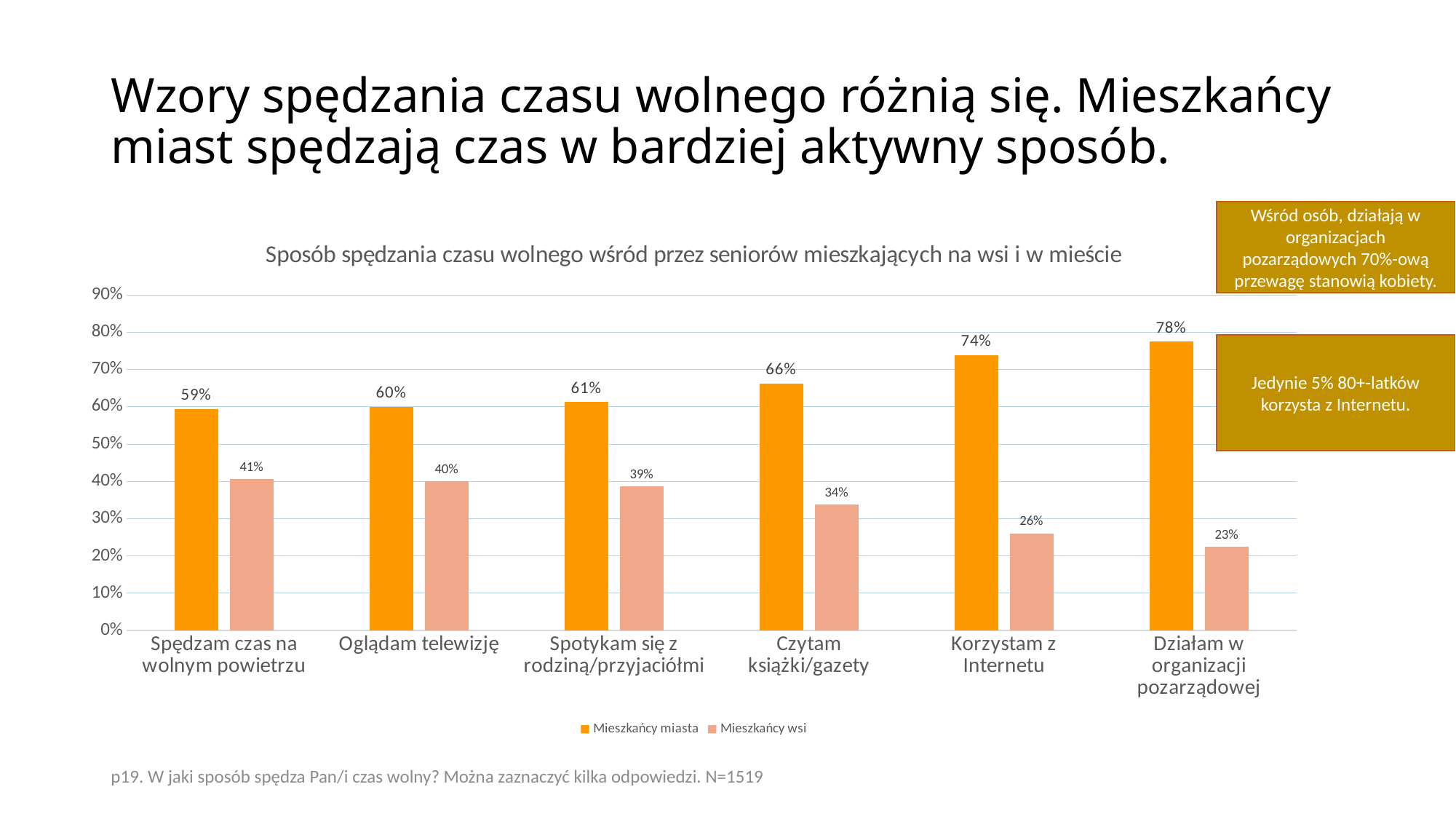
Which category has the lowest value for Mieszkańcy wsi? Działam w organizacji pozarządowej What kind of chart is shown on the slide? Bar chart What is the value for Mieszkańcy wsi in the category Czytam książki/gazety? 34% What is the value for Mieszkańcy wsi in the category Spędzam czas na wolnym powietrzu? 41% Which category has the highest value for Mieszkańcy miasta? Działam w organizacji pozarządowej Which is larger: Mieszkańcy wsi for Spotykam się z rodziną/przyjaciółmi or Mieszkańcy wsi for Korzystam z Internetu? Spotykam się z rodziną/przyjaciółmi How many series does the legend list? 2 What is the difference between Mieszkańcy miasta and Mieszkańcy wsi in the category Oglądam telewizję? 20% What is the difference between Mieszkańcy miasta and Mieszkańcy wsi in the category Działam w organizacji pozarządowej? 55% How many categories are shown on the x axis? 6 What is the value for Mieszkańcy miasta in the category Korzystam z Internetu? 74% What is the title of the chart? Sposób spędzania czasu wolnego wśród przez seniorów mieszkających na wsi i w mieście